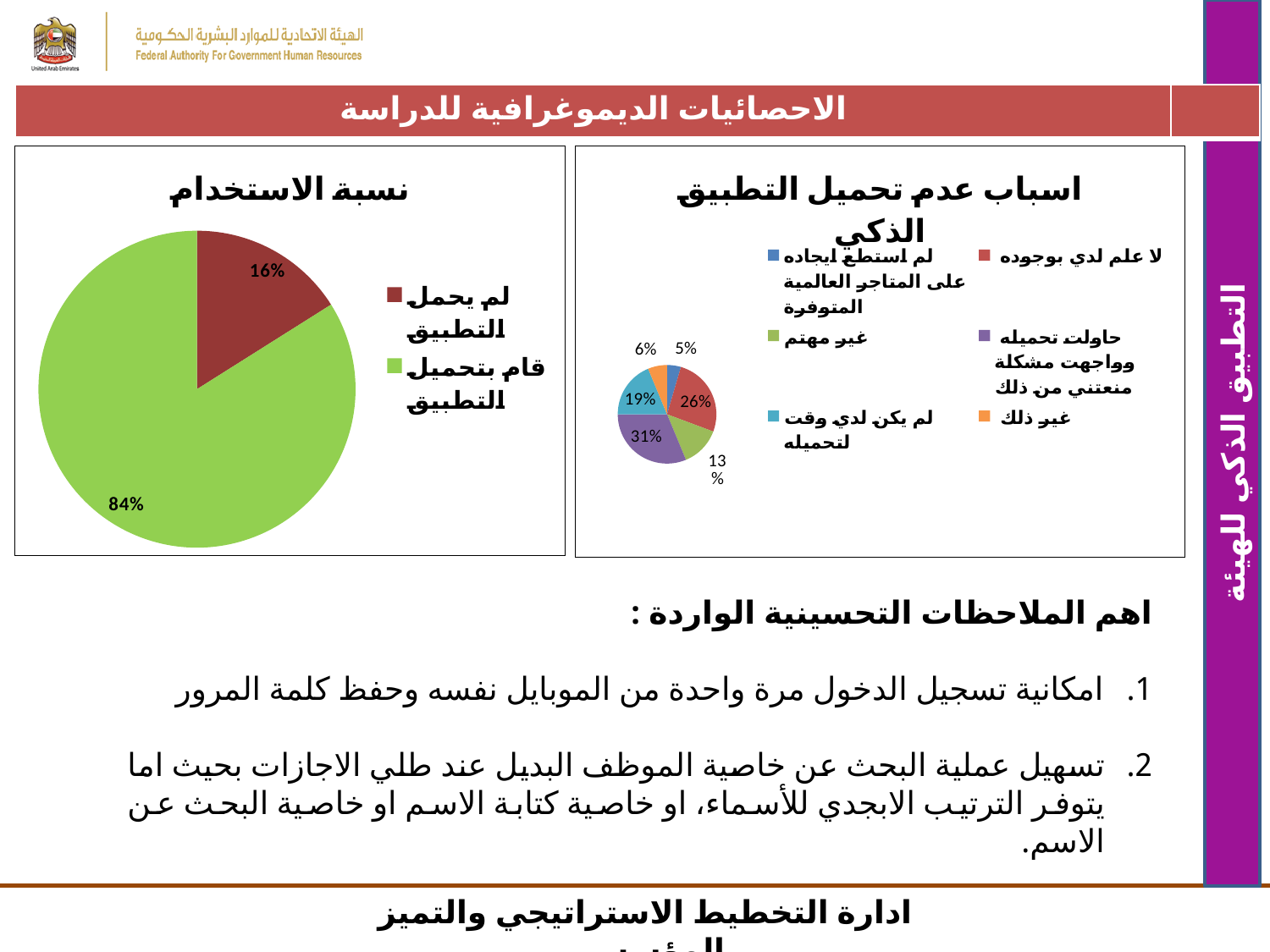
In the chart titled نسبة الاستخدام, what is the difference in percentage points between قام بتحميل التطبيق and لم يحمل التطبيق? 68 In the chart titled اسباب عدم تحميل التطبيق الذكي, which reason has the largest share? حاولت تحميله وواجهت مشكلة منعتني من ذلك In the chart titled اسباب عدم تحميل التطبيق الذكي, what percentage is shown for لا علم لدي بوجوده? 26% In the chart titled اسباب عدم تحميل التطبيق الذكي, which is larger: لا علم لدي بوجوده or لم يكن لدي وقت لتحميله? لا علم لدي بوجوده In the chart titled اسباب عدم تحميل التطبيق الذكي, what percentage is shown for لم يكن لدي وقت لتحميله? 19% In the chart titled نسبة الاستخدام, what percentage is shown for لم يحمل التطبيق? 16% In the chart titled اسباب عدم تحميل التطبيق الذكي, which reason has the smallest share? لم استطع ايجاده على المتاجر العالمية المتوفرة What type of chart is the chart titled نسبة الاستخدام? Pie chart In the chart titled اسباب عدم تحميل التطبيق الذكي, what percentage is shown for غير مهتم? 13% In the chart titled نسبة الاستخدام, what percentage is shown for قام بتحميل التطبيق? 84% In the chart titled اسباب عدم تحميل التطبيق الذكي, how many categories does the legend list? 6 In the chart titled نسبة الاستخدام, which category has the larger share? قام بتحميل التطبيق